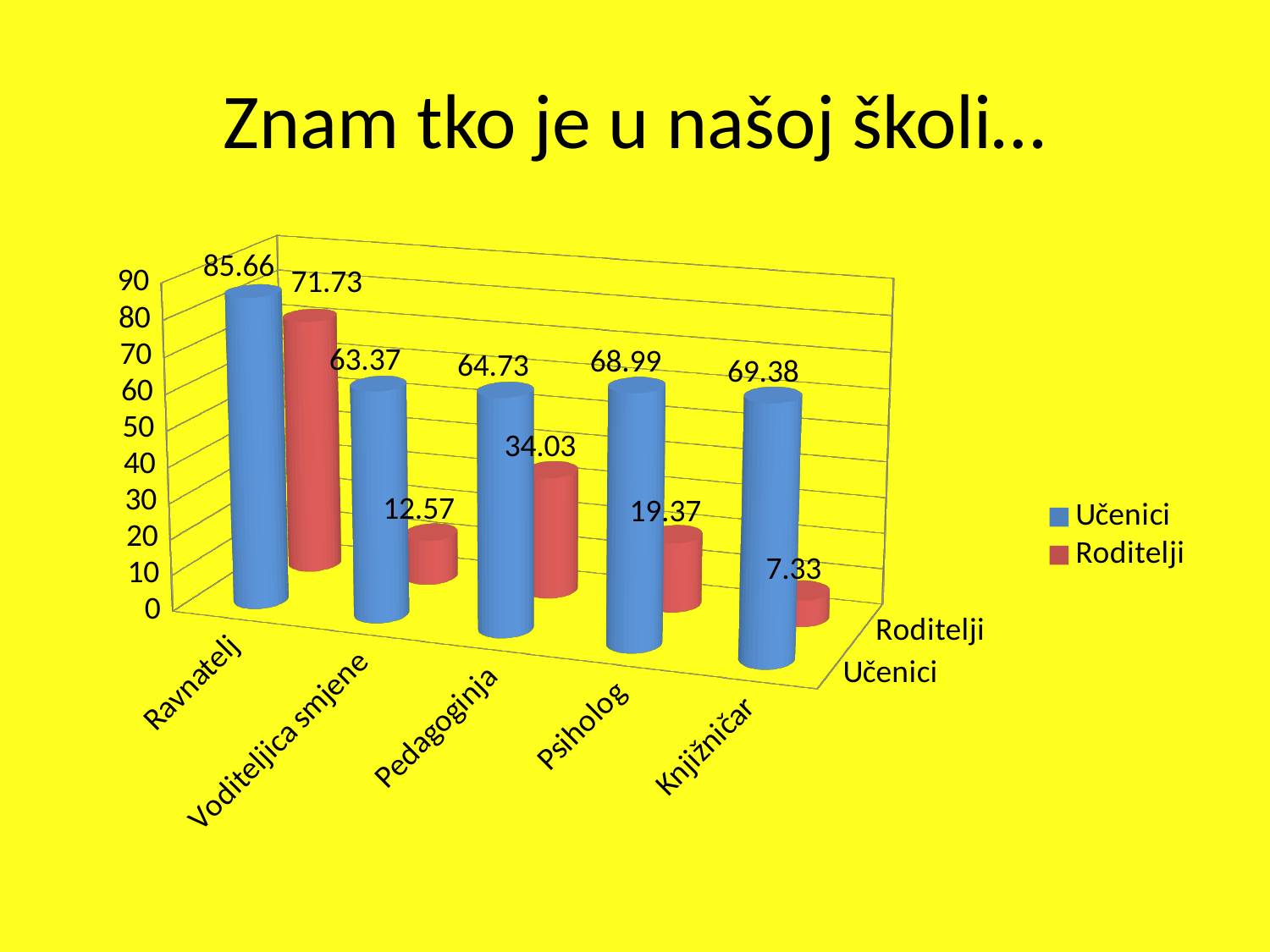
What is the value for Ravnatelj in the Učenici series? 85.66 What is the value for Knjižničar in the Roditelji series? 7.33 Which category has the lowest value in the Učenici series? Voditeljica smjene What is the difference between the Učenici and Roditelji values for Voditeljica smjene? 50.8 How many series does the legend list? 2 Which category has the highest value in the Roditelji series? Ravnatelj What is the title of the slide? Znam tko je u našoj školi… How many categories are shown on the x axis? 5 What kind of chart is shown on the slide? Bar chart What is the value for Pedagoginja in the Roditelji series? 34.03 Which is larger for Psiholog: the Učenici value or the Roditelji value? Učenici What is the value for Psiholog in the Učenici series? 68.99